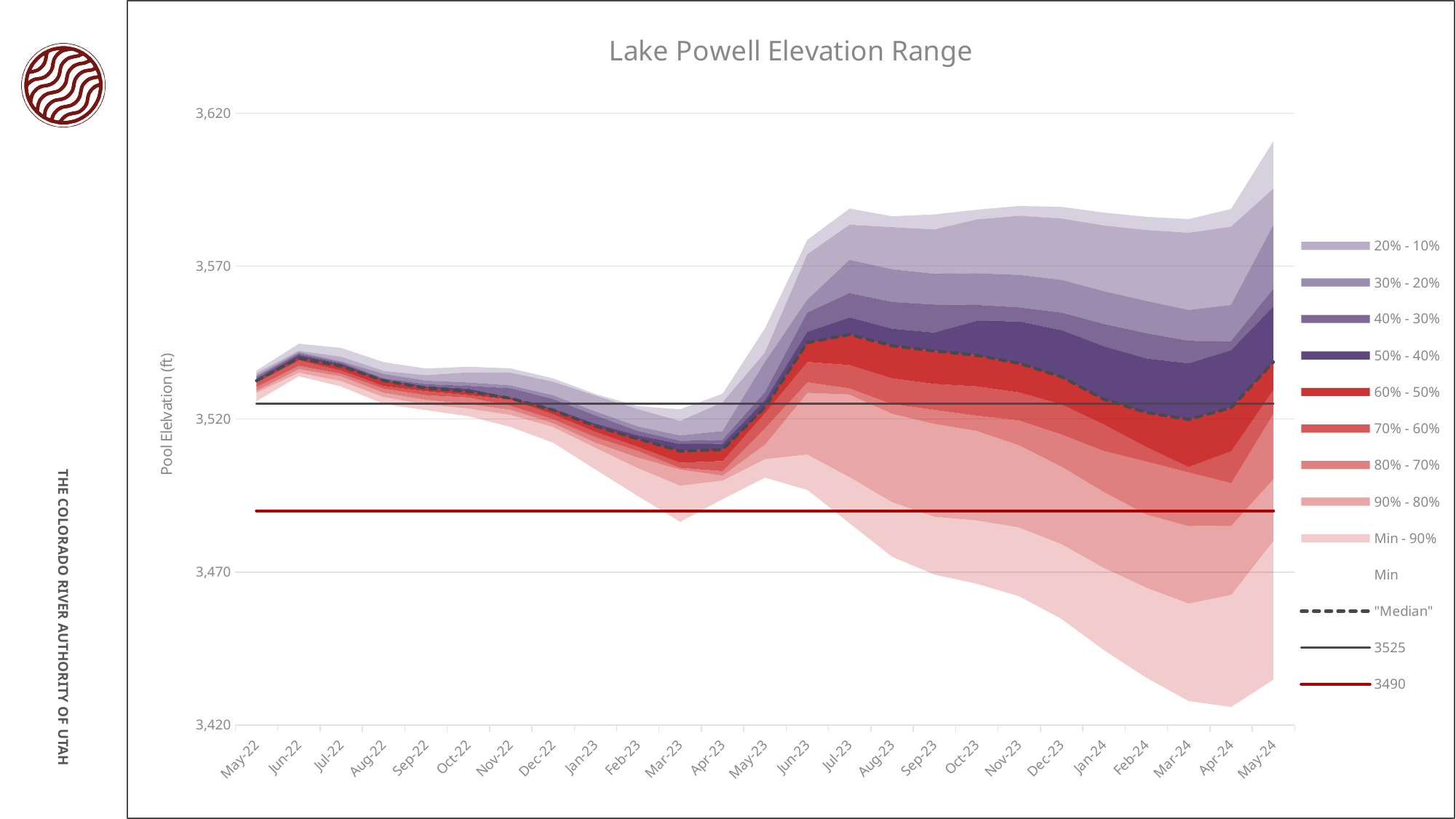
What kind of chart is shown on the slide? combination area and line chart In which month does the "Median" line reach its highest value? Jul-23 How many months are labelled along the x axis of the chart? 25 Is the "Median" value for Jul-23 greater or less than 3,520? greater Which is larger, the "Median" value for Jul-23 or for Mar-23? Jul-23 What is the title of the chart? Lake Powell Elevation Range How many entries does the chart's legend list? 13 What elevation does the black horizontal reference line represent, according to the legend? 3525 Does the "Median" line rise or fall between Jun-22 and Mar-23? fall Is the "Median" value for Mar-23 greater or less than 3,520? less What is the lowest tick value shown on the y axis? 3,420 What elevation does the red horizontal reference line represent, according to the legend? 3490